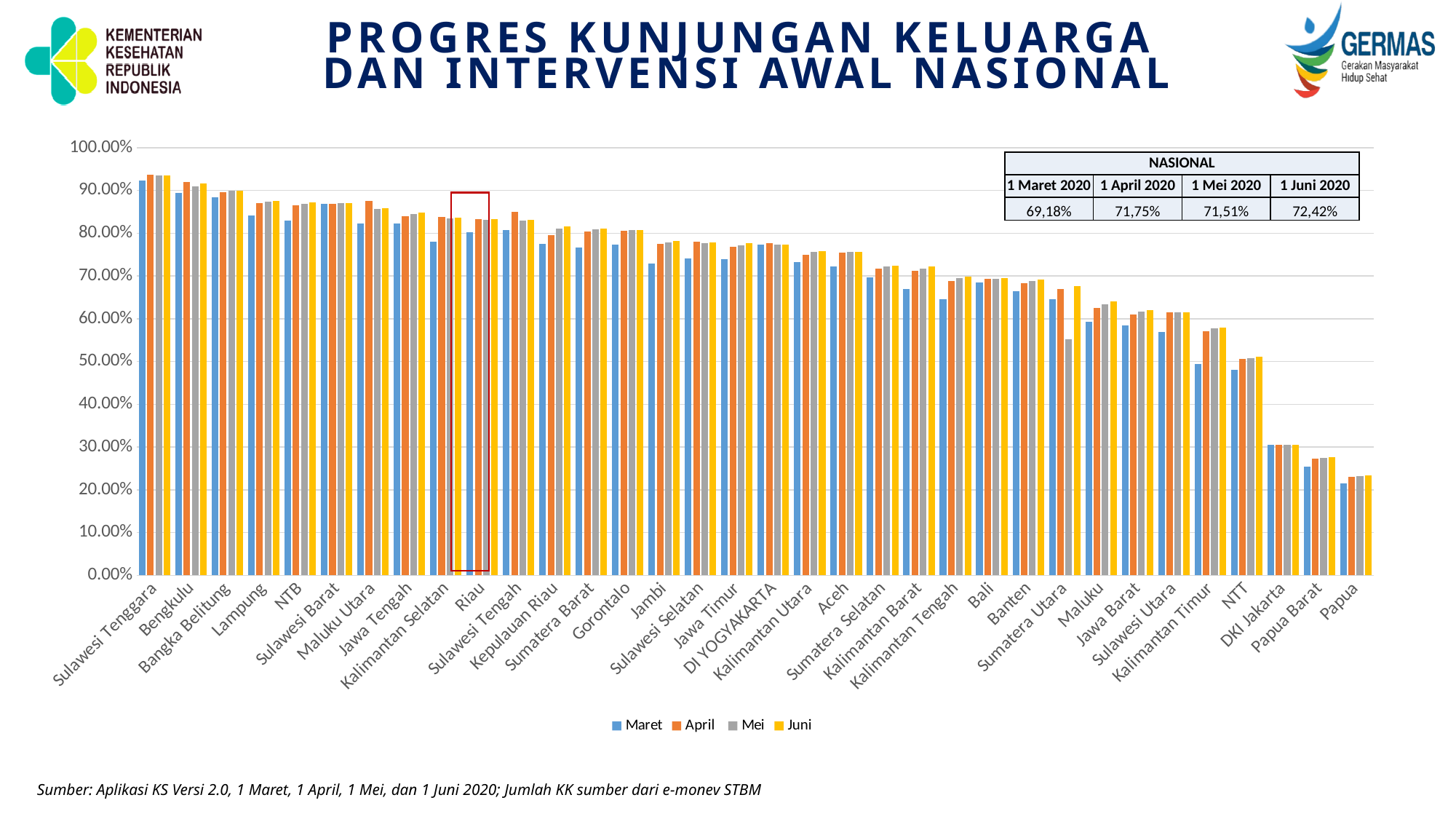
Is the Maret value for Bengkulu greater or less than 80%? greater What kind of chart is shown on the slide? bar chart According to the NASIONAL table on the chart, what is the national value for 1 Juni 2020? 72,42% Do the values generally rise or fall moving from left to right along the x axis? fall How many series does the legend list? 4 Which province has the lowest values in the chart? Papua How many provinces are shown along the x axis of the chart? 34 What are the four legend entries of the chart? Maret, April, Mei, Juni Which is larger, the Juni value for Papua Barat or the Juni value for Kalimantan Timur? Kalimantan Timur Is the Juni value for NTT greater or less than 60%? less Which province has the highest Juni value in the chart? Sulawesi Tenggara Is the Juni value for DKI Jakarta greater or less than 40%? less